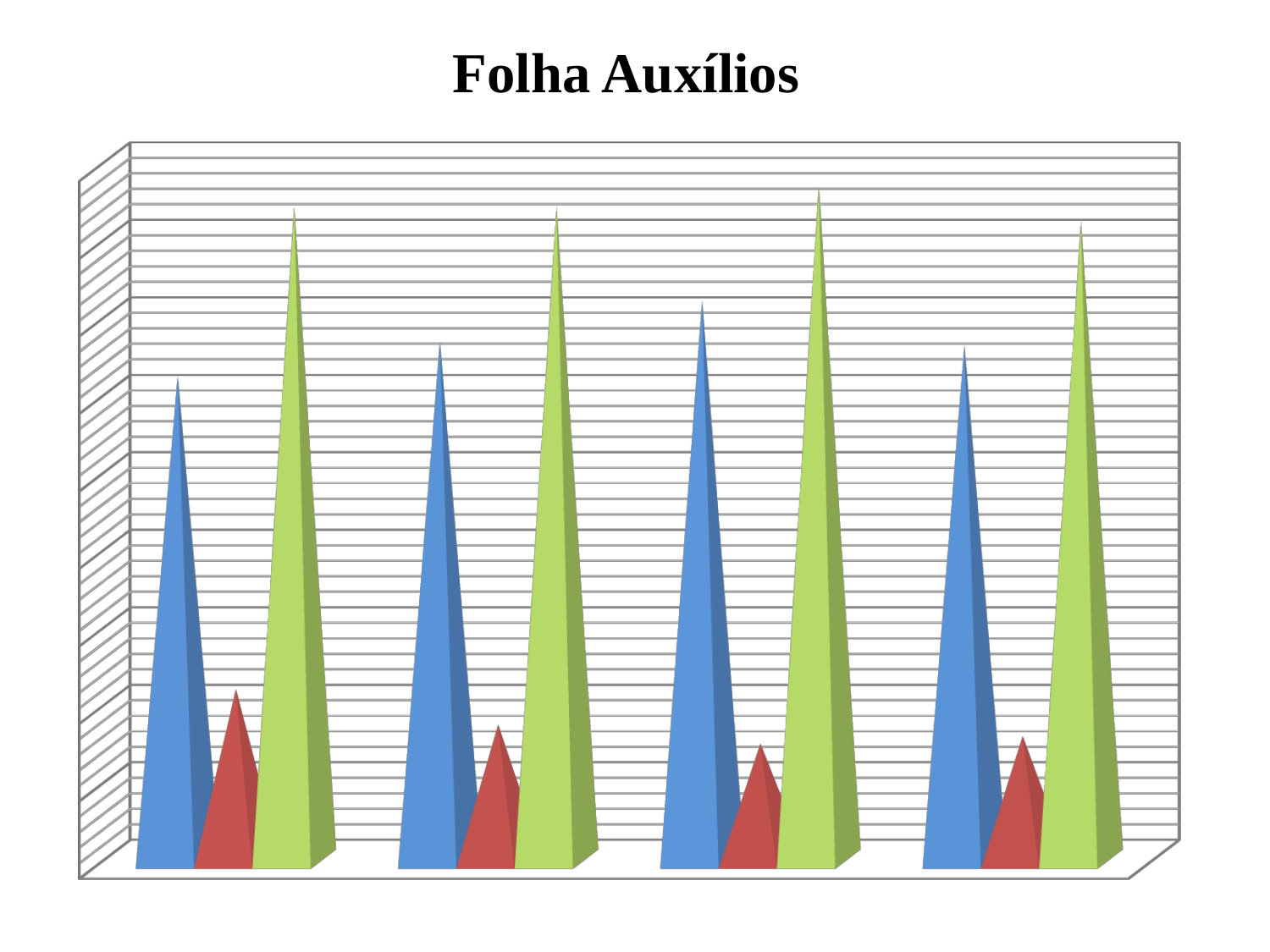
Which group from the left has the tallest blue bar? the third group What kind of chart is shown on the slide? bar chart How many groups of bars are plotted along the x axis? 4 In the first group from the left, which colour bar is the shortest? red In the third group from the left, is the blue bar taller or shorter than the green bar? shorter Which group from the left has the tallest green bar? the third group Which colour series is the tallest in every group? green Which group from the left has the tallest red bar? the first group How many differently coloured series are plotted in each group? 3 In the first group from the left, which colour bar is the tallest? green What is the title of the chart? Folha Auxílios